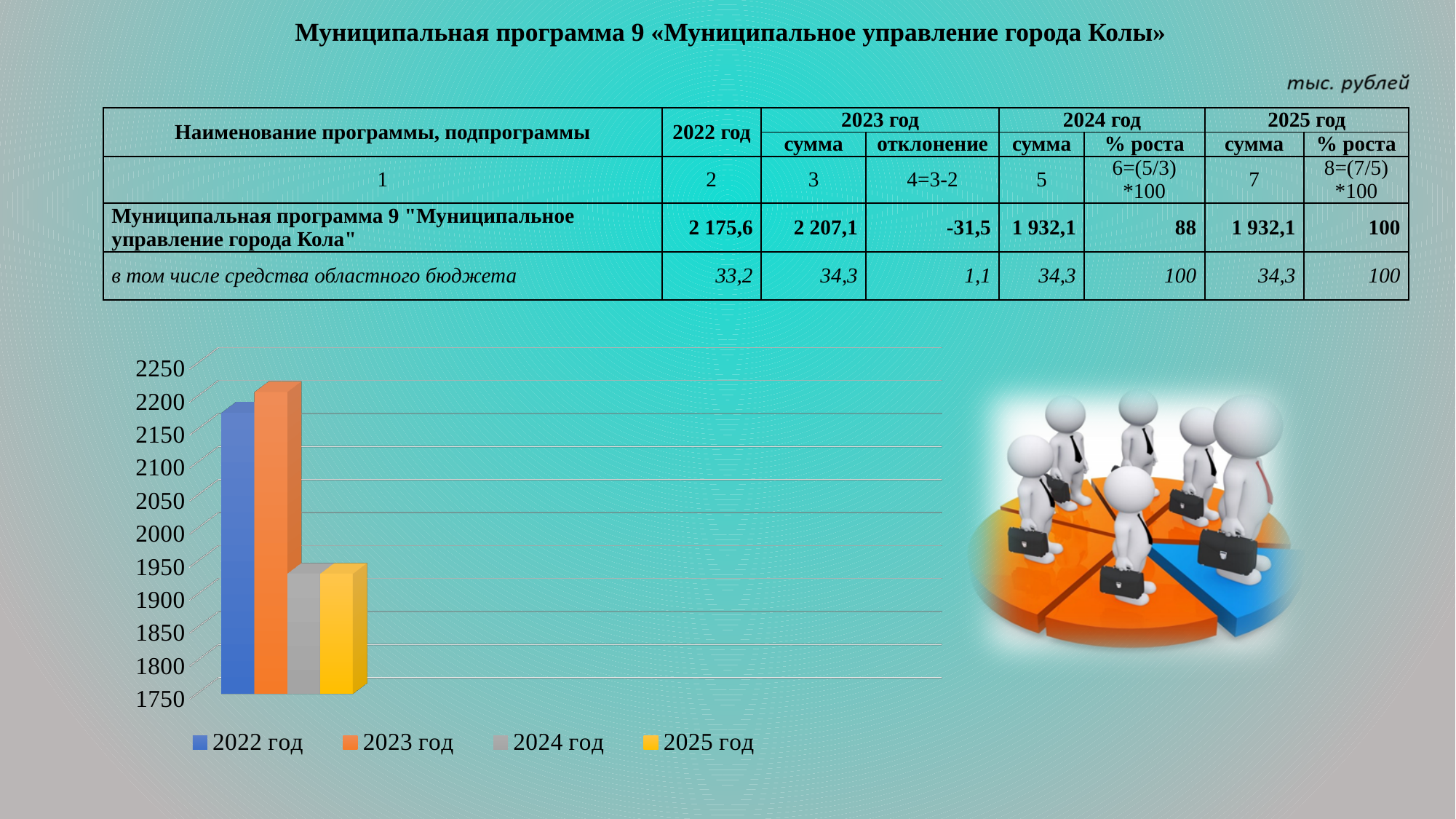
What kind of chart is shown on the slide? bar chart Which bar is taller in the chart, 2022 год or 2024 год? 2022 год What is the lowest value shown on the chart's vertical axis? 1750 Is the value for 2023 год in the chart greater or less than 2150? greater Is the value for 2025 год in the chart greater or less than 2000? less What colour is the bar for 2025 год in the chart? yellow Is the value for 2022 год in the chart greater or less than 2150? greater Which bar is taller in the chart, 2022 год or 2023 год? 2023 год Does the bar value rise or fall from 2023 год to 2024 год? fall How many series does the chart legend list? 4 Which year has the highest bar in the chart? 2023 год